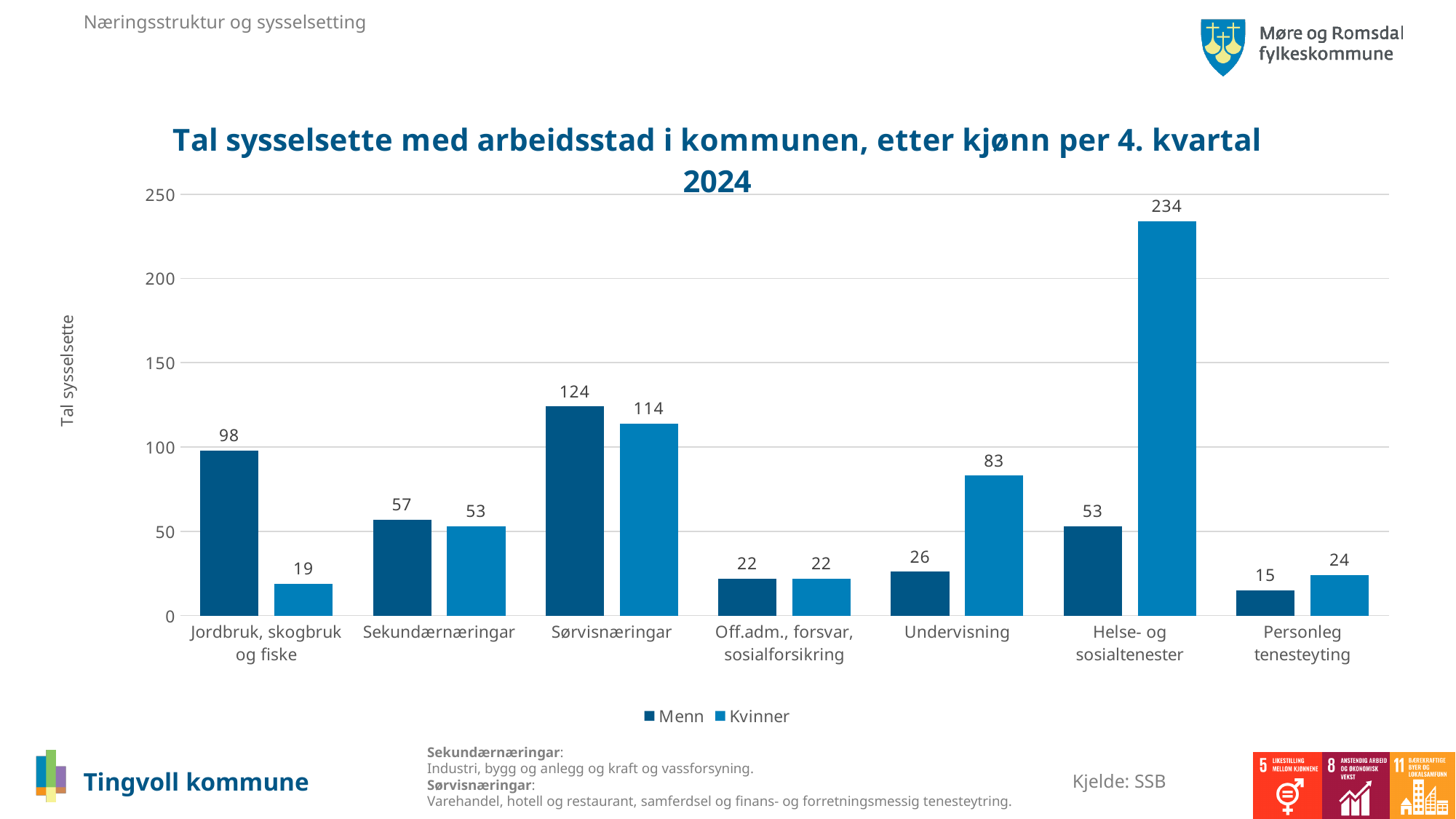
Which is larger in Undervisning, Menn or Kvinner? Kvinner What is the value for Kvinner in Helse- og sosialtenester? 234 What is the value for Kvinner in Jordbruk, skogbruk og fiske? 19 How many series does the legend list? 2 What kind of chart is shown? Bar chart How many categories are shown on the x axis? 7 Which category has the lowest value for Menn? Personleg tenesteyting What is the value for Menn in Sørvisnæringar? 124 What is the label of the y axis? Tal sysselsette Which category has the highest value for Kvinner? Helse- og sosialtenester What is the difference between Kvinner and Menn in Helse- og sosialtenester? 181 What is the total of Menn and Kvinner in Sekundærnæringar? 110